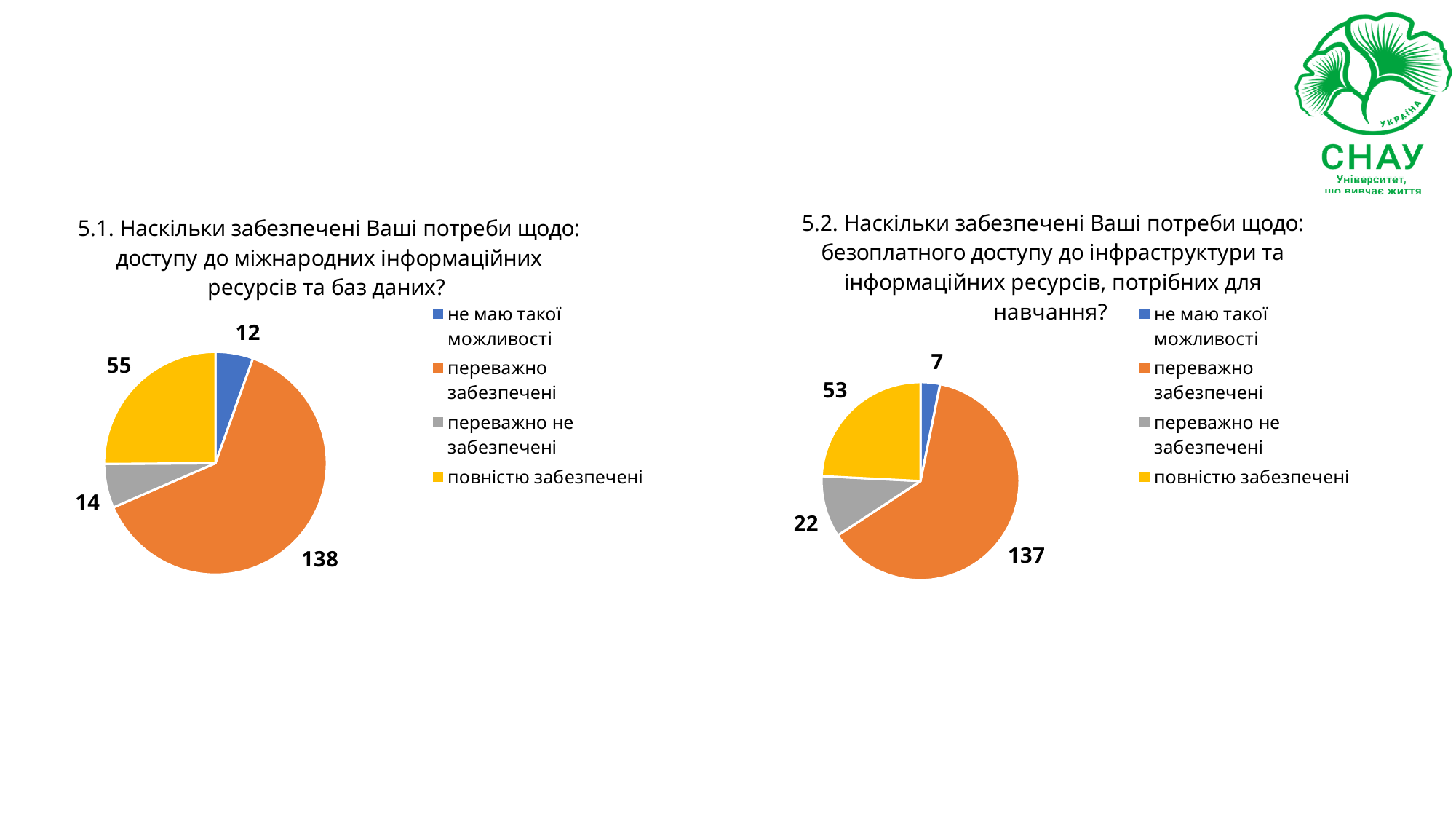
In the left chart (5.1), what colour is the slice for "повністю забезпечені"? yellow In the left chart (5.1), which category has the largest slice? переважно забезпечені In the right chart (5.2), what is the difference between the values for "переважно забезпечені" and "повністю забезпечені"? 84 How many slices does the left chart (5.1) have? 4 In the right chart (5.2), which category has the smallest slice? не маю такої можливості In the right chart (5.2), what is the value for "повністю забезпечені"? 53 What type of chart is the right chart (5.2)? pie chart In the right chart (5.2), which is larger: "переважно не забезпечені" or "не маю такої можливості"? переважно не забезпечені In the left chart (5.1), what is the value for "переважно забезпечені"? 138 In the right chart (5.2), what is the value for "переважно не забезпечені"? 22 In the left chart (5.1), what is the difference between the values for "повністю забезпечені" and "переважно не забезпечені"? 41 In the left chart (5.1), what is the value for "не маю такої можливості"? 12